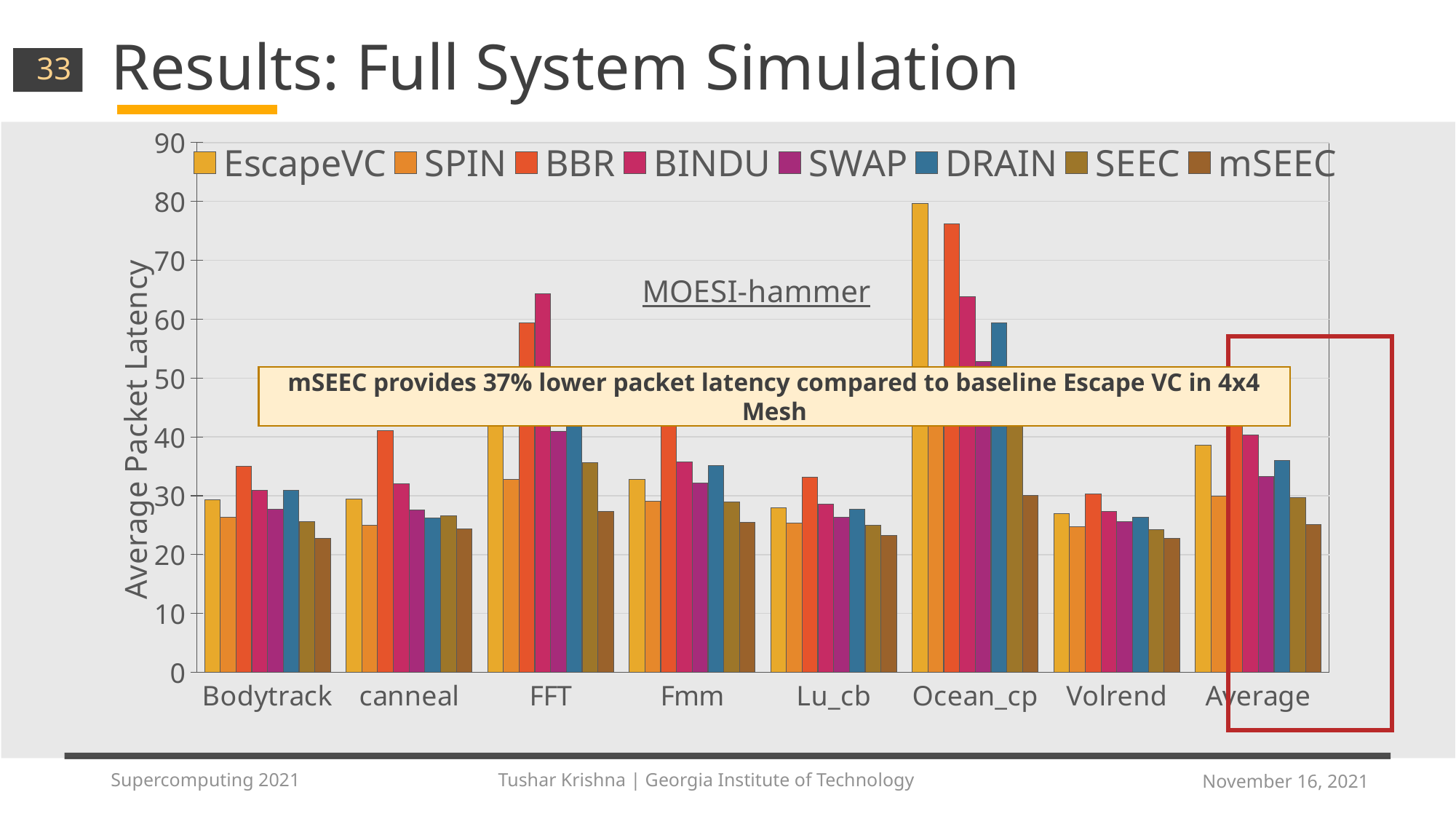
What is the label of the y axis? Average Packet Latency Which category has the highest EscapeVC bar? Ocean_cp How many benchmark categories are shown along the x axis? 8 Is the mSEEC value for Bodytrack greater or less than 30? less For Bodytrack, which is larger: the BBR value or the SPIN value? BBR How many series does the legend list? 8 Is the BINDU value for FFT greater or less than 60? greater What kind of chart is shown on the slide? bar chart Is the SPIN value for Average greater or less than 40? less Which series is listed first in the legend? EscapeVC In the Average group, which series has the lowest bar? mSEEC